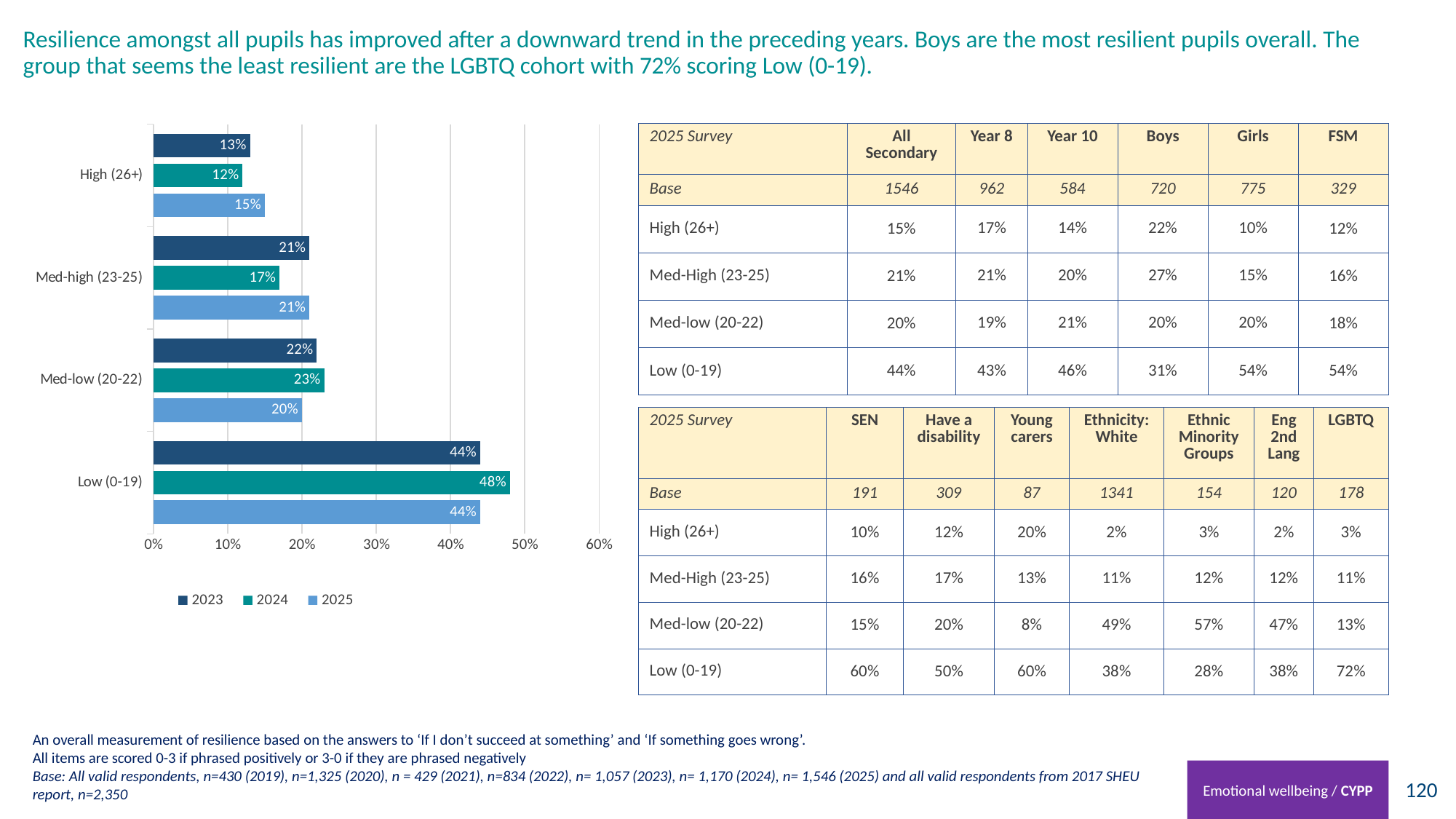
How many series does the chart legend list? 3 What kind of chart is shown on the slide? Bar chart What is the value for Med-high (23-25) in the 2024 series? 17% Which category has the lowest value in the 2024 series? High (26+) Which series is shown in the darkest blue colour in the chart legend? 2023 What is the value for High (26+) in the 2025 series? 15% Which is larger for Med-high (23-25): the 2023 value or the 2024 value? 2023 How many categories are shown on the chart? 4 What is the difference between the 2024 and 2025 values for Low (0-19)? 4% What is the value for Med-low (20-22) in the 2023 series? 22% What is the value for Low (0-19) in the 2024 series? 48% Which category has the highest value in the 2025 series? Low (0-19)